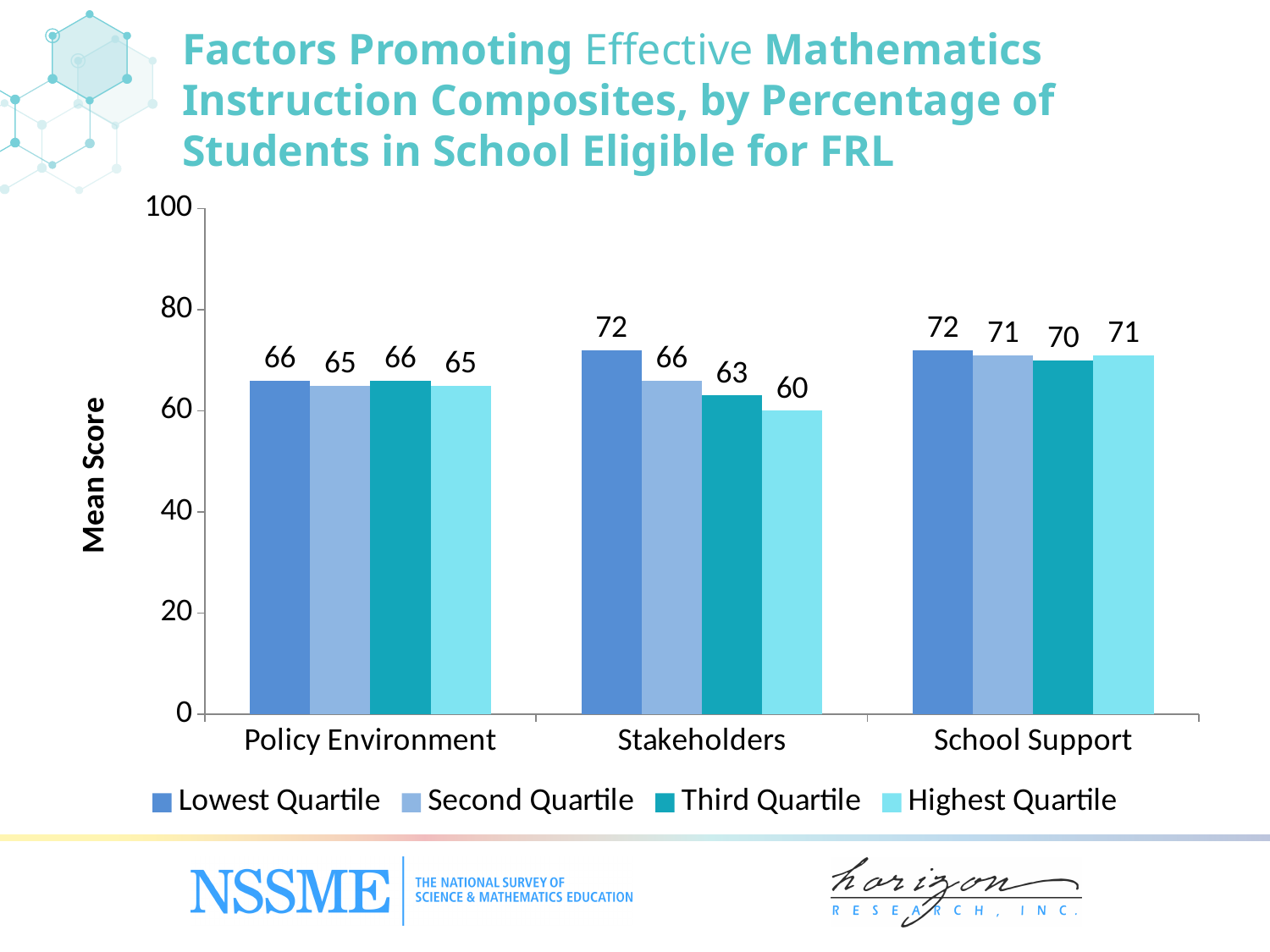
Which quartile has the lowest mean score in the Stakeholders category? Highest Quartile How many series does the legend list? 4 How many categories are shown on the x axis? 3 What is the mean score for the Highest Quartile in the Stakeholders category? 60 What is the mean score for the Third Quartile in the School Support category? 70 What kind of chart is shown on the slide? Bar chart What is the difference between the Lowest Quartile and Highest Quartile mean scores in the Stakeholders category? 12 Which is larger: the Lowest Quartile mean score for Stakeholders or the Lowest Quartile mean score for Policy Environment? Stakeholders What is the label of the y axis? Mean Score What is the mean score for the Lowest Quartile in the Stakeholders category? 72 What is the mean score for the Second Quartile in the Policy Environment category? 65 Is the Highest Quartile mean score for Stakeholders greater or less than 80? less